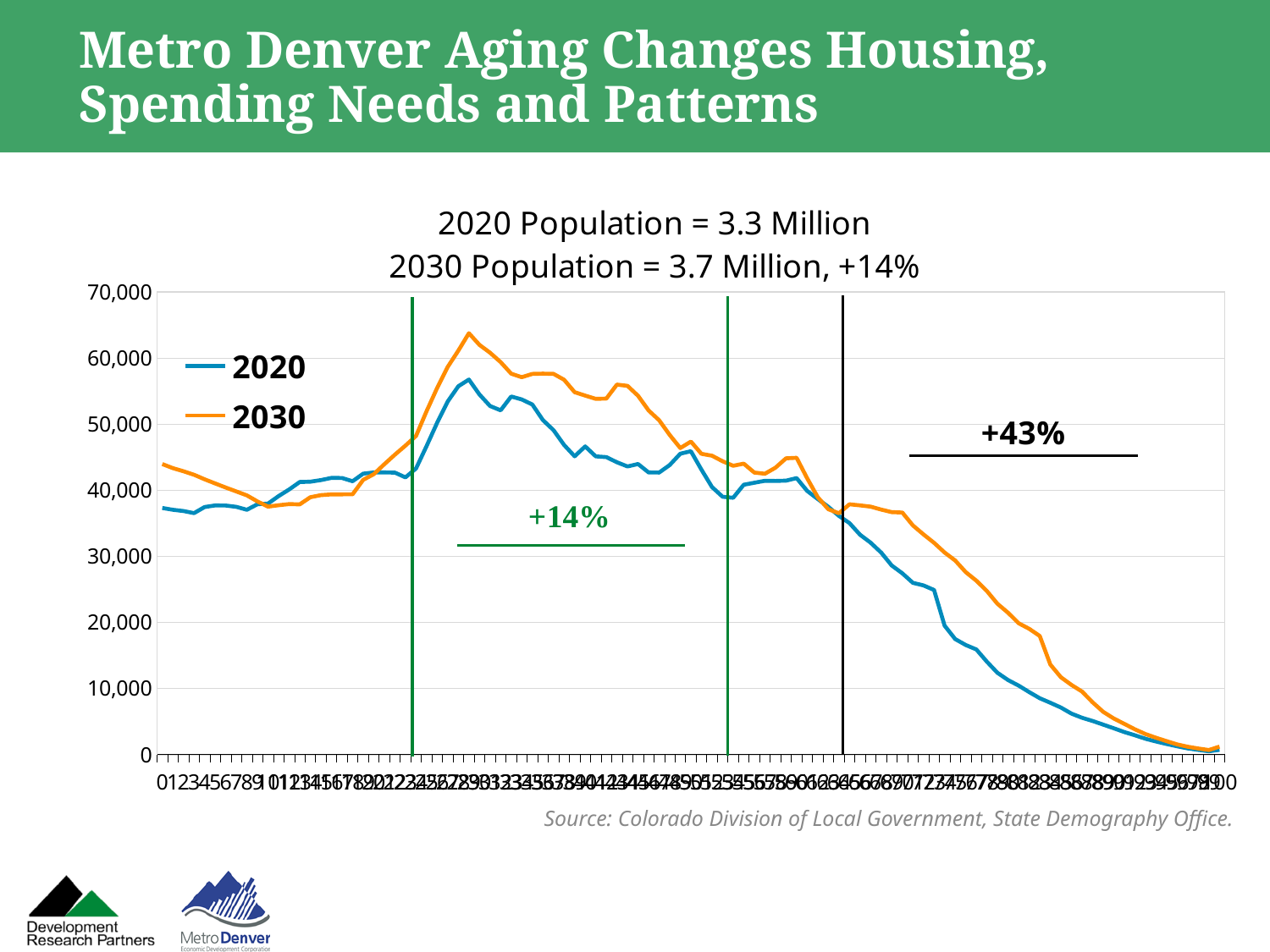
At the left end of the x axis (age 0), which series has the higher value, 2020 or 2030? 2030 What is the chart's title? 2020 Population = 3.3 Million 2030 Population = 3.7 Million, +14% What percentage change is annotated above the right-hand (older age) section of the chart? +43% At the left end of the x axis (age 0), is the 2030 value greater or less than 40,000? greater What kind of chart is shown on the slide? line chart What percentage change is annotated in green between the two green vertical lines? +14% Do the values of both lines rise or fall along the x axis after the black vertical line toward the right end? fall Is the peak value of the 2030 line greater or less than 60,000? greater Which series reaches the higher peak value, 2020 or 2030? 2030 What are the two series named in the legend? 2020 and 2030 Is the peak value of the 2020 line greater or less than 60,000? less How many series does the legend list? 2